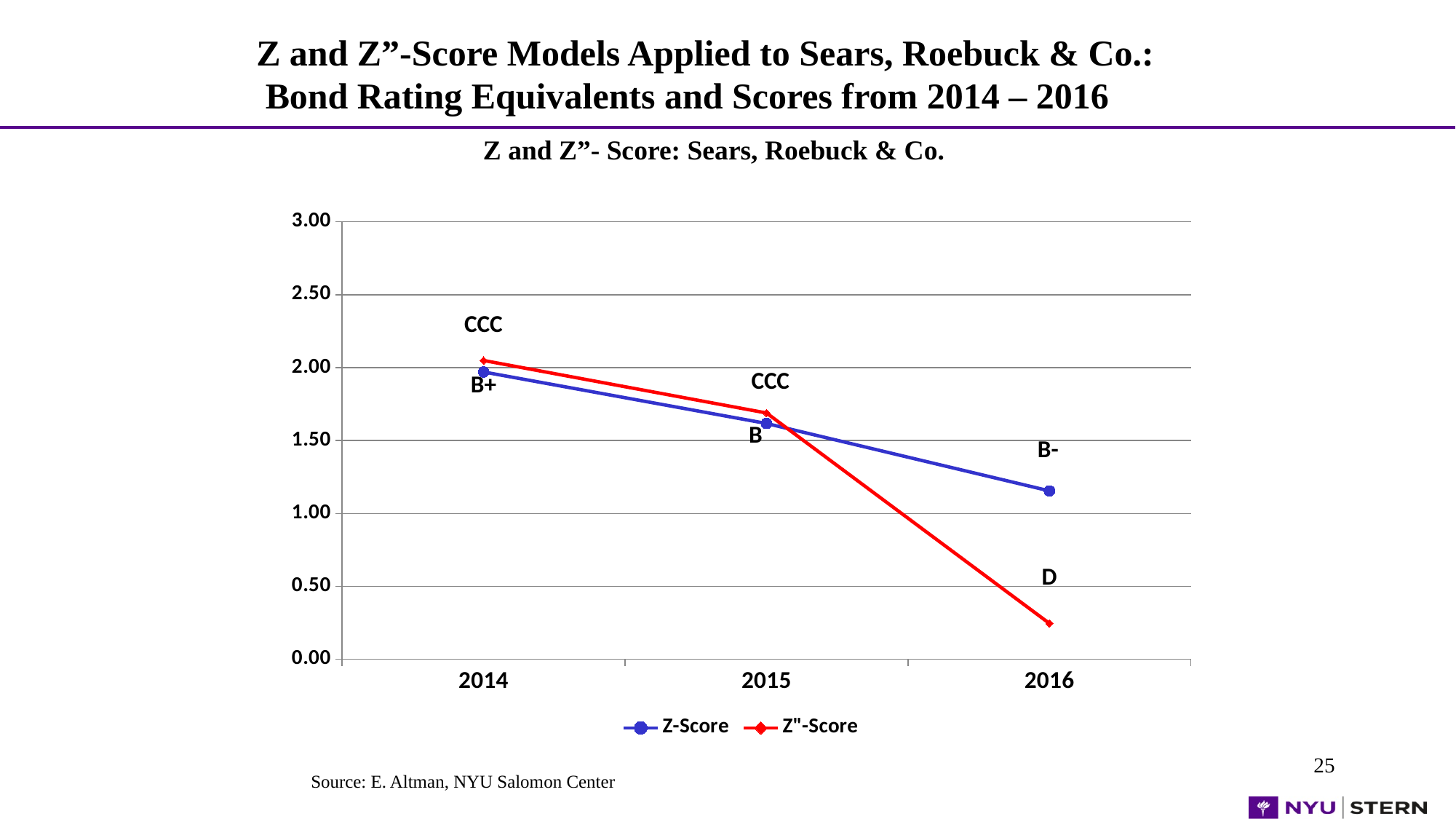
In which year is the Z"-Score lowest? 2016 What bond rating equivalent is labelled for the Z-Score in 2016? B- What bond rating equivalent is labelled for the Z"-Score in 2015? CCC What bond rating equivalent is labelled for the Z-Score in 2014? B+ What kind of chart is shown on the slide? line chart In 2016, which series has the larger value, Z-Score or Z"-Score? Z-Score Do the Z-Score values rise or fall from 2014 to 2016? fall What bond rating equivalent is labelled for the Z"-Score in 2016? D How many series does the legend list? 2 How many years are plotted on the x axis? 3 Is the Z-Score value for 2016 greater or less than 1.00? greater Is the Z"-Score value for 2016 greater or less than 0.50? less